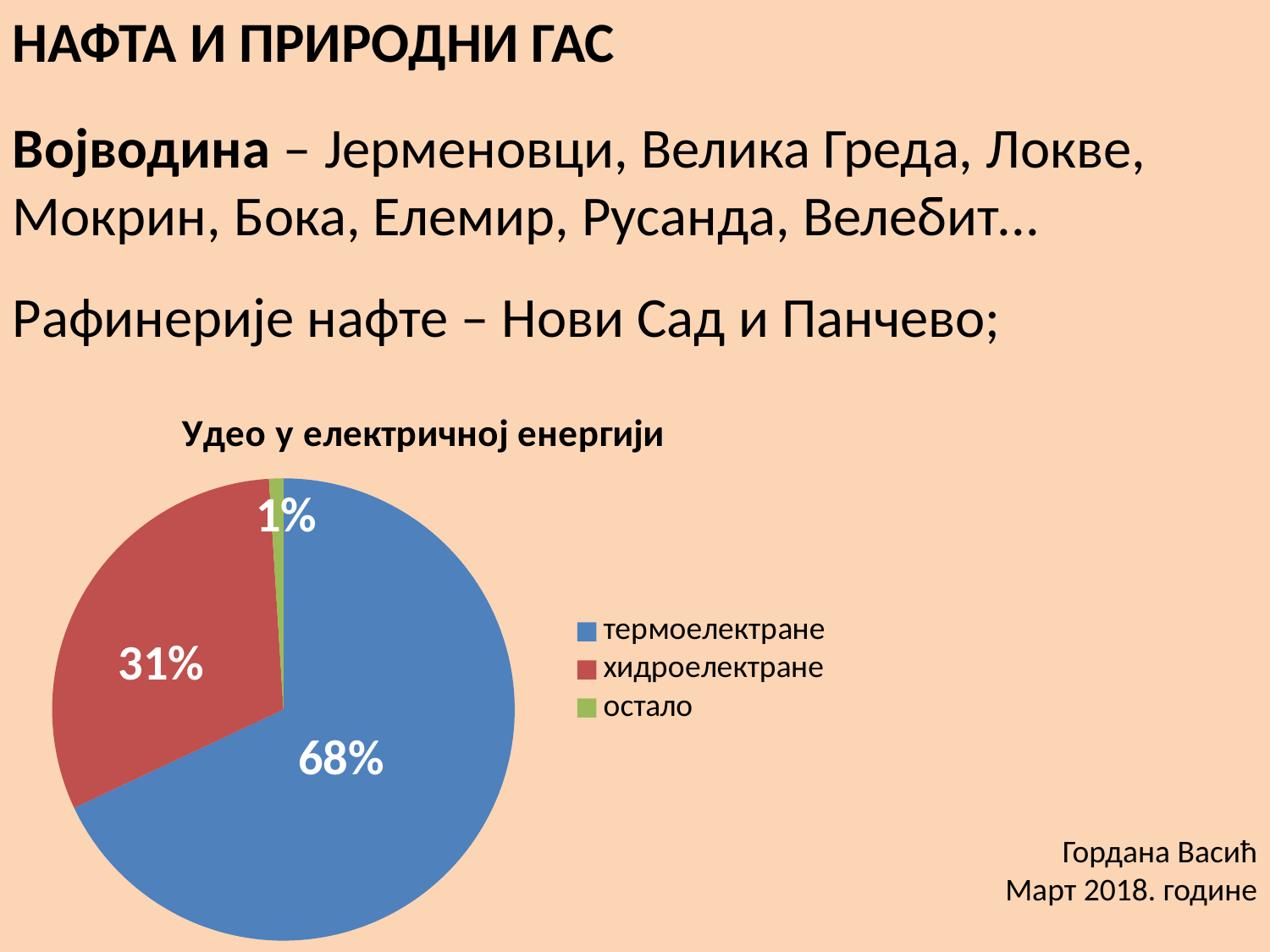
What is the title of the chart? Удео у електричној енергији Which is larger, the share of хидроелектране or the share of остало? хидроелектране How many categories does the legend list? 3 What share of the pie does термоелектране have? 68% What share of the pie does хидроелектране have? 31% What share of the pie does остало have? 1% What type of chart is shown on the slide? pie chart Which category has the smallest share? остало Which category has the largest share? термоелектране What colour is the slice for хидроелектране? red What is the difference between the shares of хидроелектране and остало? 30% What is the difference between the shares of термоелектране and хидроелектране? 37%